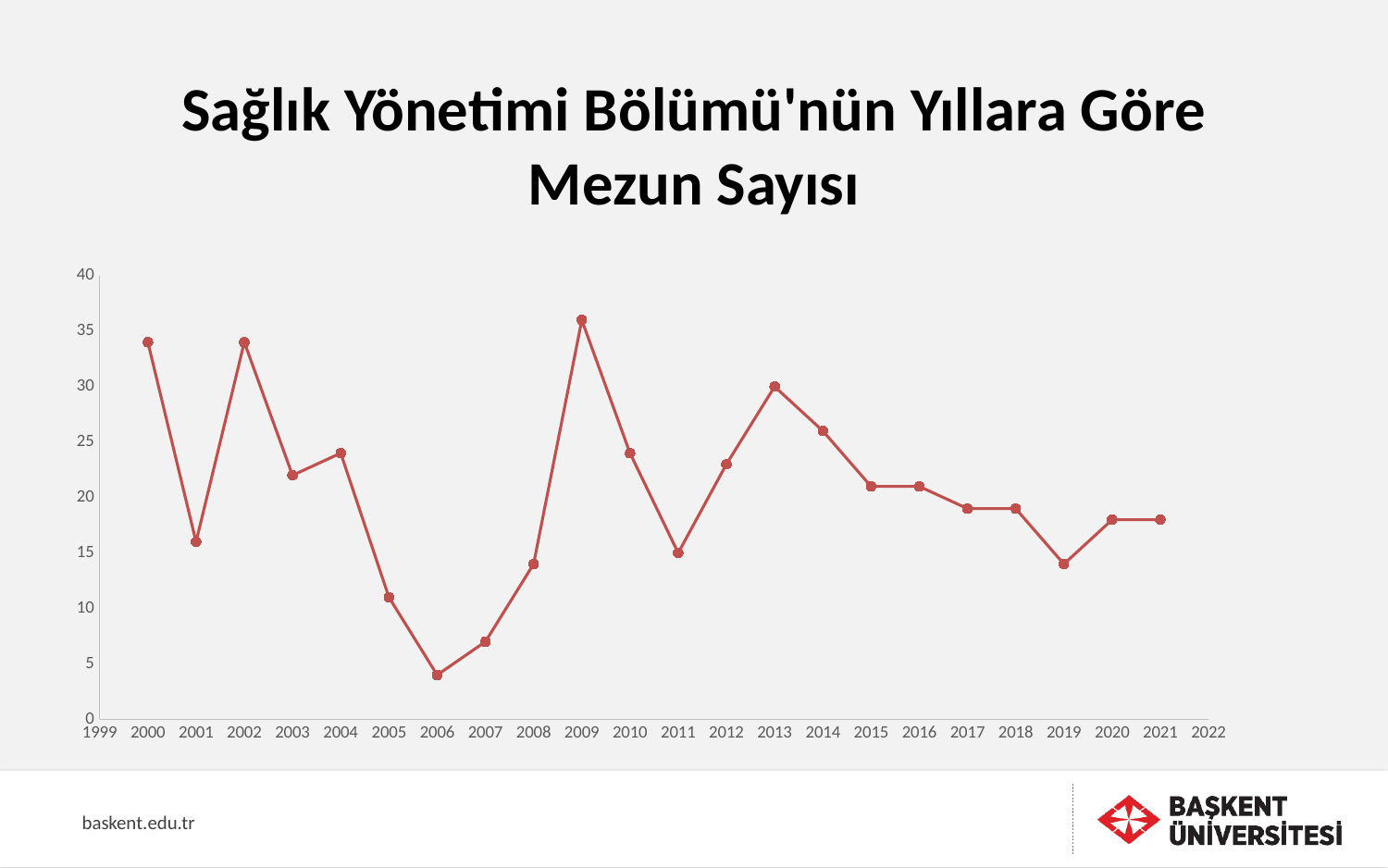
Is the value for 2011 greater or less than 20? less Do the values rise or fall from 2013 to 2019? fall Is the value for 2013 greater or less than 25? greater What kind of chart is shown on the slide? line chart Which year has the lowest number of graduates? 2006 Which year has a larger value, 2000 or 2001? 2000 Which year has the highest number of graduates? 2009 Which year has a larger value, 2006 or 2007? 2007 What is the title of the chart? Sağlık Yönetimi Bölümü'nün Yıllara Göre Mezun Sayısı How many years (data points) are plotted on the chart? 22 Is the value for 2000 greater or less than 30? greater